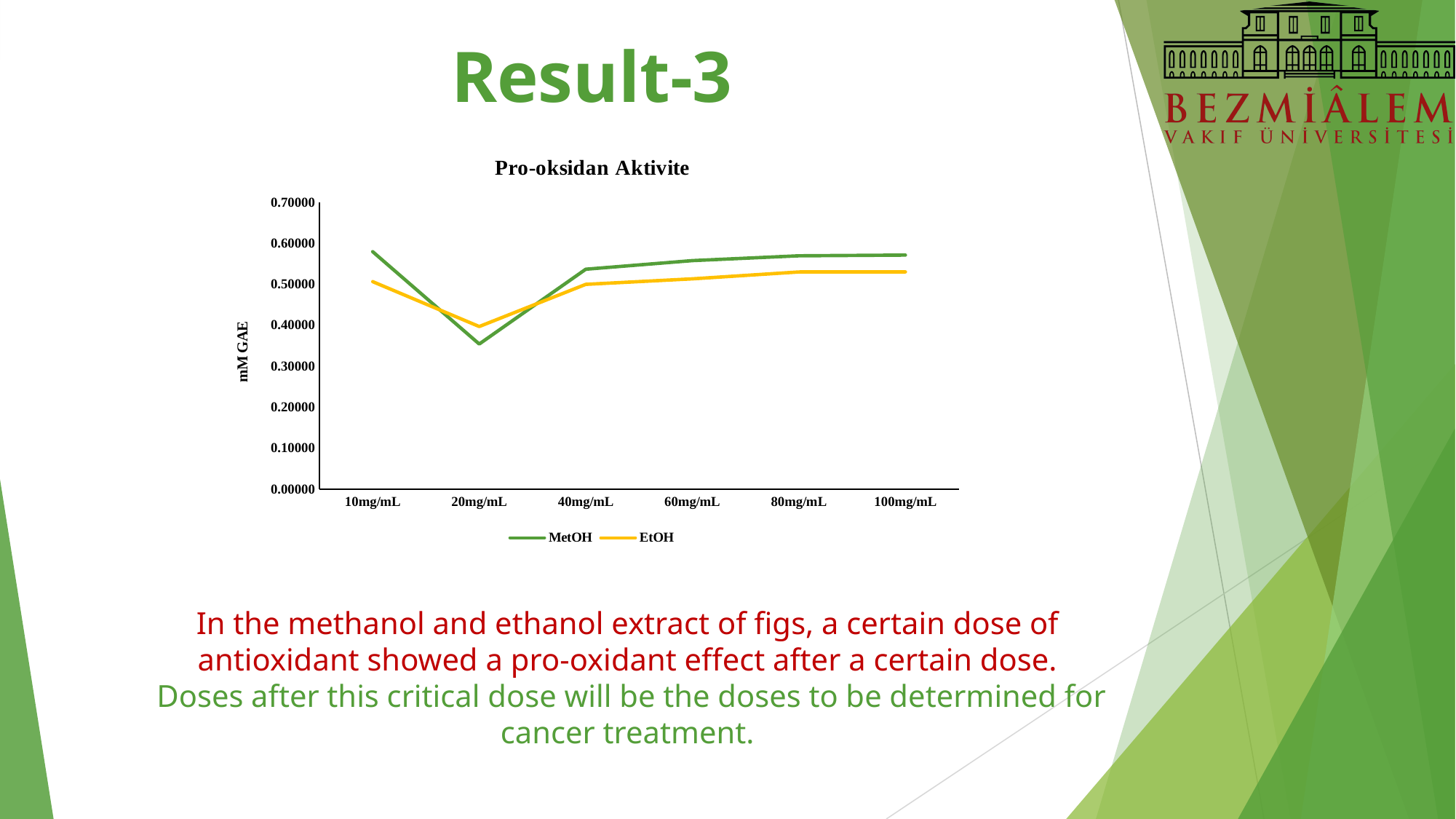
At which concentration is the MetOH value lowest? 20mg/mL At 10mg/mL, which series has the higher value, MetOH or EtOH? MetOH Is the MetOH value at 20mg/mL greater or less than 0.40000? less Is the MetOH value at 10mg/mL greater or less than 0.50000? greater What kind of chart is shown on the slide? line chart What is the title of the chart? Pro-oksidan Aktivite At which concentration is the EtOH value lowest? 20mg/mL How many series does the legend list? 2 Is the EtOH value at 20mg/mL greater or less than 0.30000? greater Does the MetOH line rise or fall from 20mg/mL to 100mg/mL? rise How many concentration categories are shown on the x axis? 6 At 20mg/mL, which series has the higher value, MetOH or EtOH? EtOH